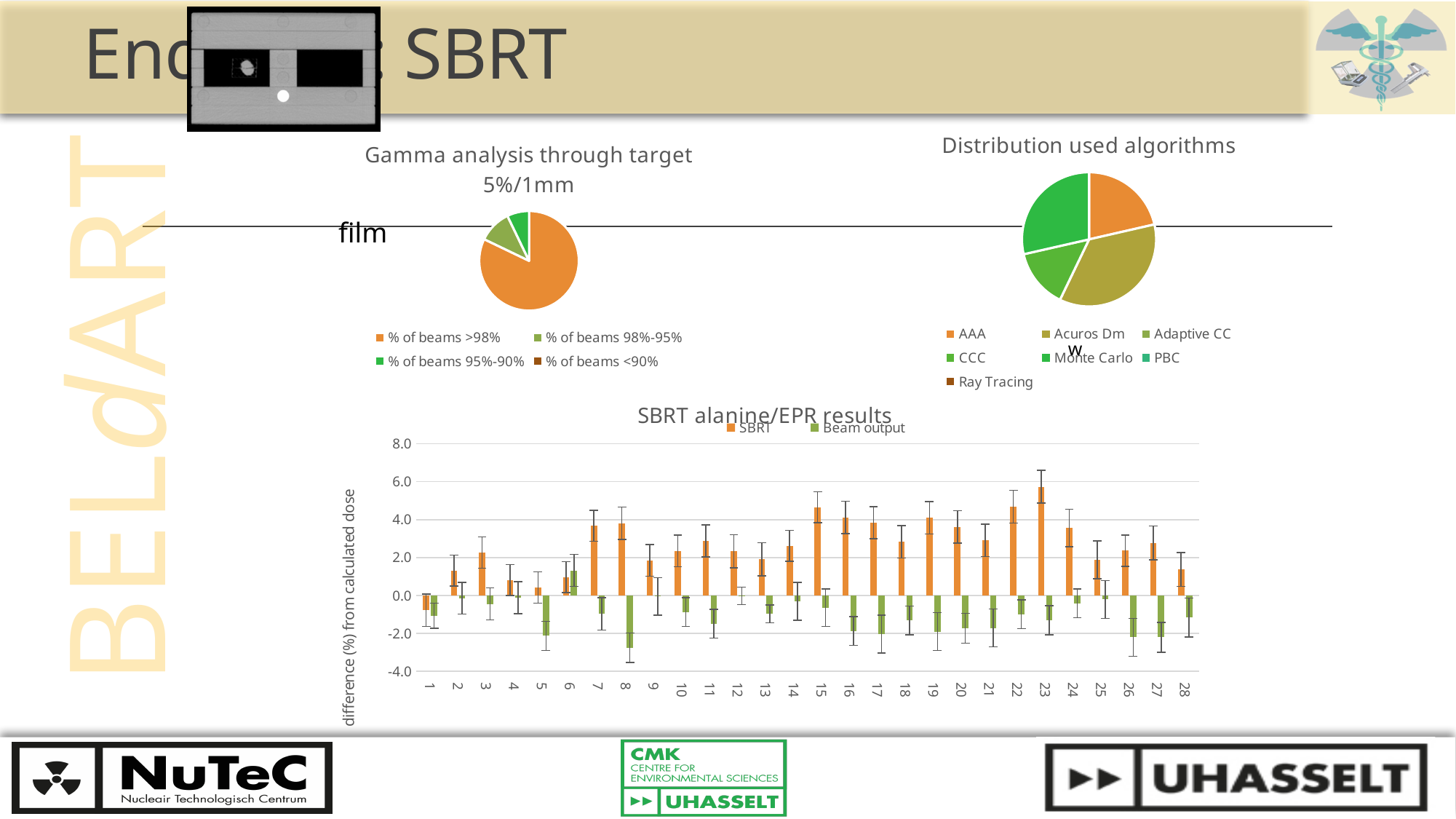
How many entries does the legend of the "Distribution used algorithms" chart list? 7 In the "SBRT alanine/EPR results" chart, which category has the highest SBRT value? 23 How many series does the legend of the "SBRT alanine/EPR results" chart list? 2 What kind of chart is the "Gamma analysis through target 5%/1mm" chart? pie chart In the "SBRT alanine/EPR results" chart, which is larger: the SBRT value for category 15 or for category 5? 15 How many entries does the legend of the "Gamma analysis through target 5%/1mm" chart list? 4 What kind of chart is the "SBRT alanine/EPR results" chart? bar chart What kind of chart is the "Distribution used algorithms" chart? pie chart In the "Gamma analysis through target 5%/1mm" chart, which category has the largest slice? % of beams >98% In the "SBRT alanine/EPR results" chart, is the SBRT value for category 23 greater or less than 4.0? greater In the "SBRT alanine/EPR results" chart, is the Beam output value for category 8 greater or less than -2.0? less How many categories are shown on the x axis of the "SBRT alanine/EPR results" chart? 28